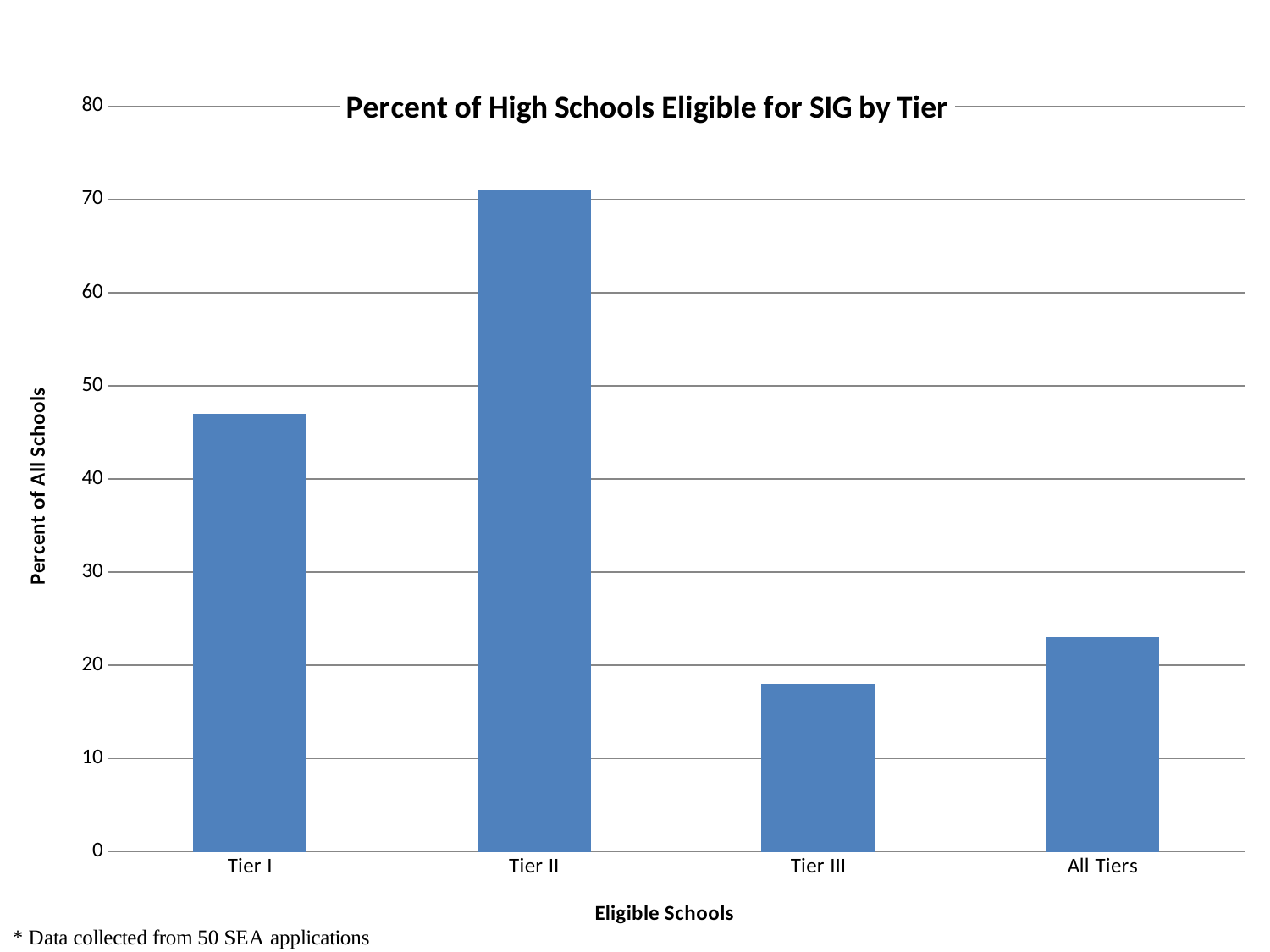
What is the label of the y axis? Percent of All Schools Which is larger, the value for Tier III or the value for All Tiers? All Tiers Is the value for Tier I greater or less than 40? greater Which category has the lowest percent of high schools eligible for SIG? Tier III What kind of chart is shown on the slide? bar chart Which is larger, the value for Tier I or the value for All Tiers? Tier I Which tier has the highest percent of high schools eligible for SIG? Tier II What is the title of the chart? Percent of High Schools Eligible for SIG by Tier Is the value for Tier III greater or less than 20? less Is the value for All Tiers greater or less than 20? greater How many categories are shown on the x axis? 4